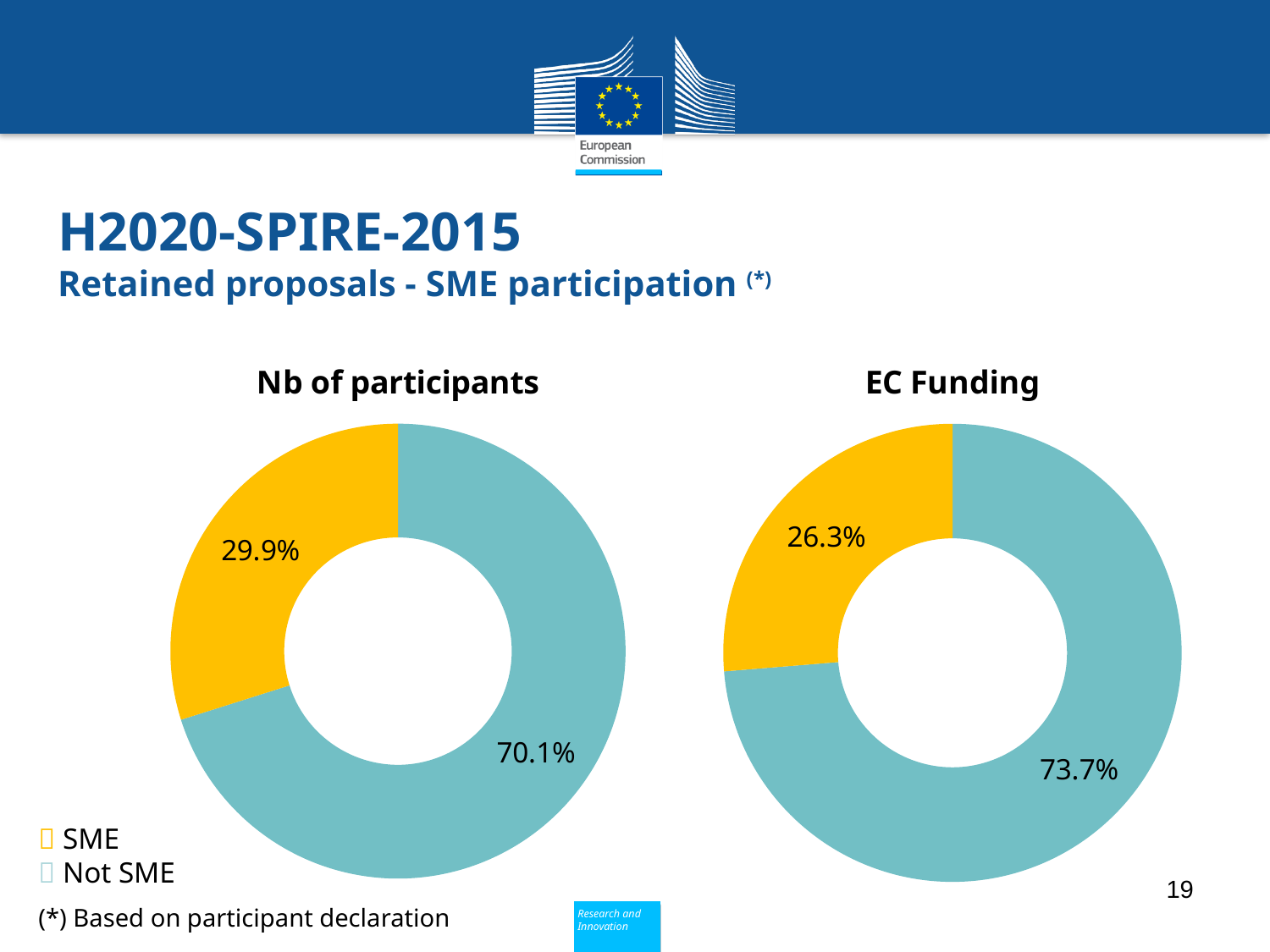
Which colour represents SME in the charts? Yellow In the 'Nb of participants' chart, what share is labelled for SME? 29.9% How many categories does the 'Nb of participants' chart show? 2 In the 'Nb of participants' chart, which category has the smallest share? SME In the 'Nb of participants' chart, what is the difference between the Not SME and SME shares? 40.2% In the 'EC Funding' chart, what share is labelled for Not SME? 73.7% In the 'Nb of participants' chart, what share is labelled for Not SME? 70.1% Is the SME share larger in the 'Nb of participants' chart or in the 'EC Funding' chart? Nb of participants In the 'EC Funding' chart, which category has the largest share? Not SME What type of chart is the 'EC Funding' chart? Doughnut chart How many entries does the legend list? 2 In the 'EC Funding' chart, what share is labelled for SME? 26.3%